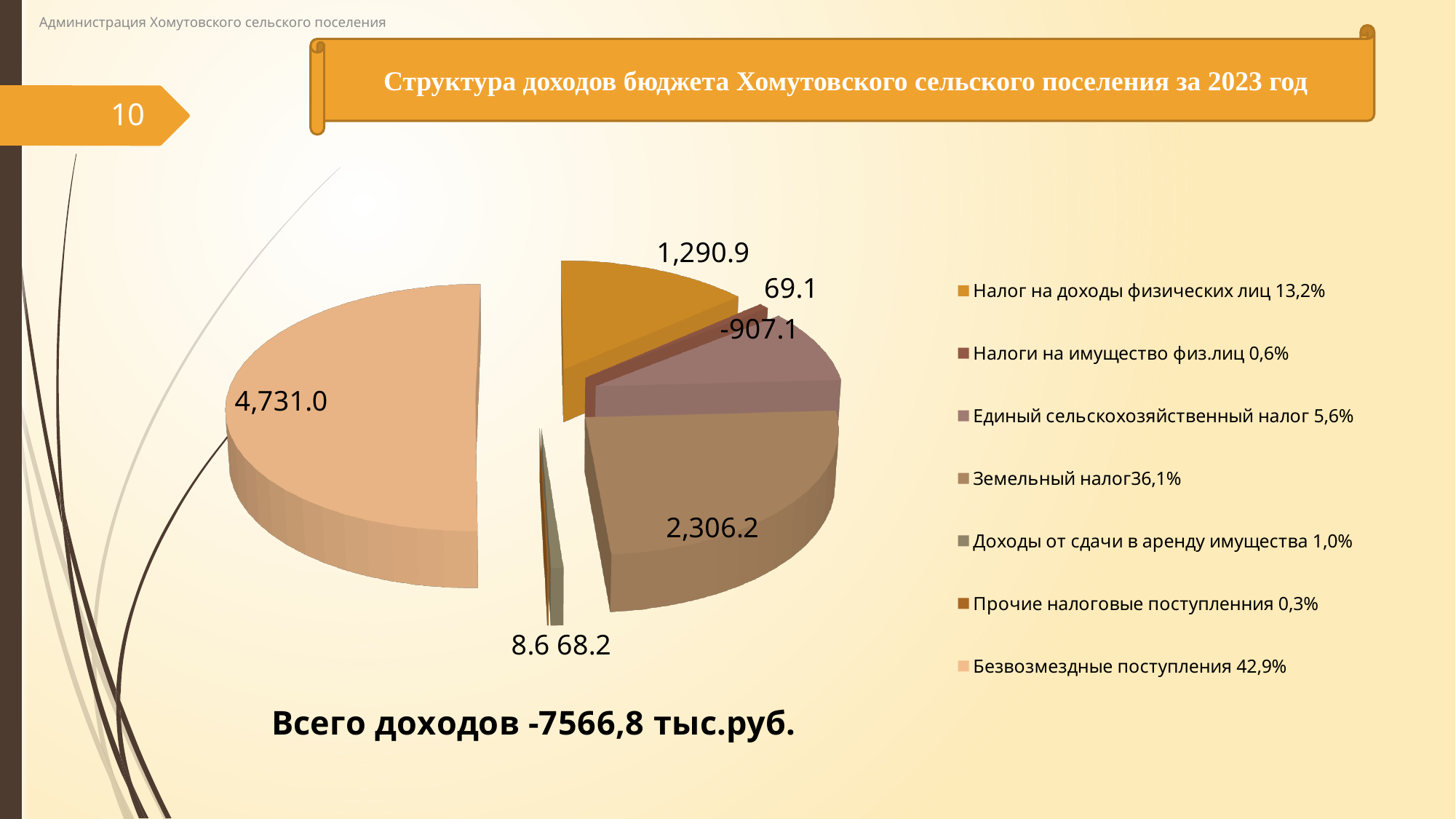
Which is larger: Земельный налог or Налог на доходы физических лиц? Земельный налог Which category has the largest slice of the pie? Безвозмездные поступления What is the value shown for Налоги на имущество физ.лиц? 69.1 What is the difference between the values for Безвозмездные поступления and Земельный налог? 2,424.8 What is the value shown for Безвозмездные поступления? 4,731.0 What kind of chart is shown on the slide? pie chart What is the value shown for Земельный налог? 2,306.2 What is the value shown for Налог на доходы физических лиц? 1,290.9 How many slices does the pie chart have? 7 According to the legend, what share of the pie is Земельный налог? 36,1% According to the legend, what share of the pie is Безвозмездные поступления? 42,9% Which category has the smallest slice of the pie? Прочие налоговые поступленния